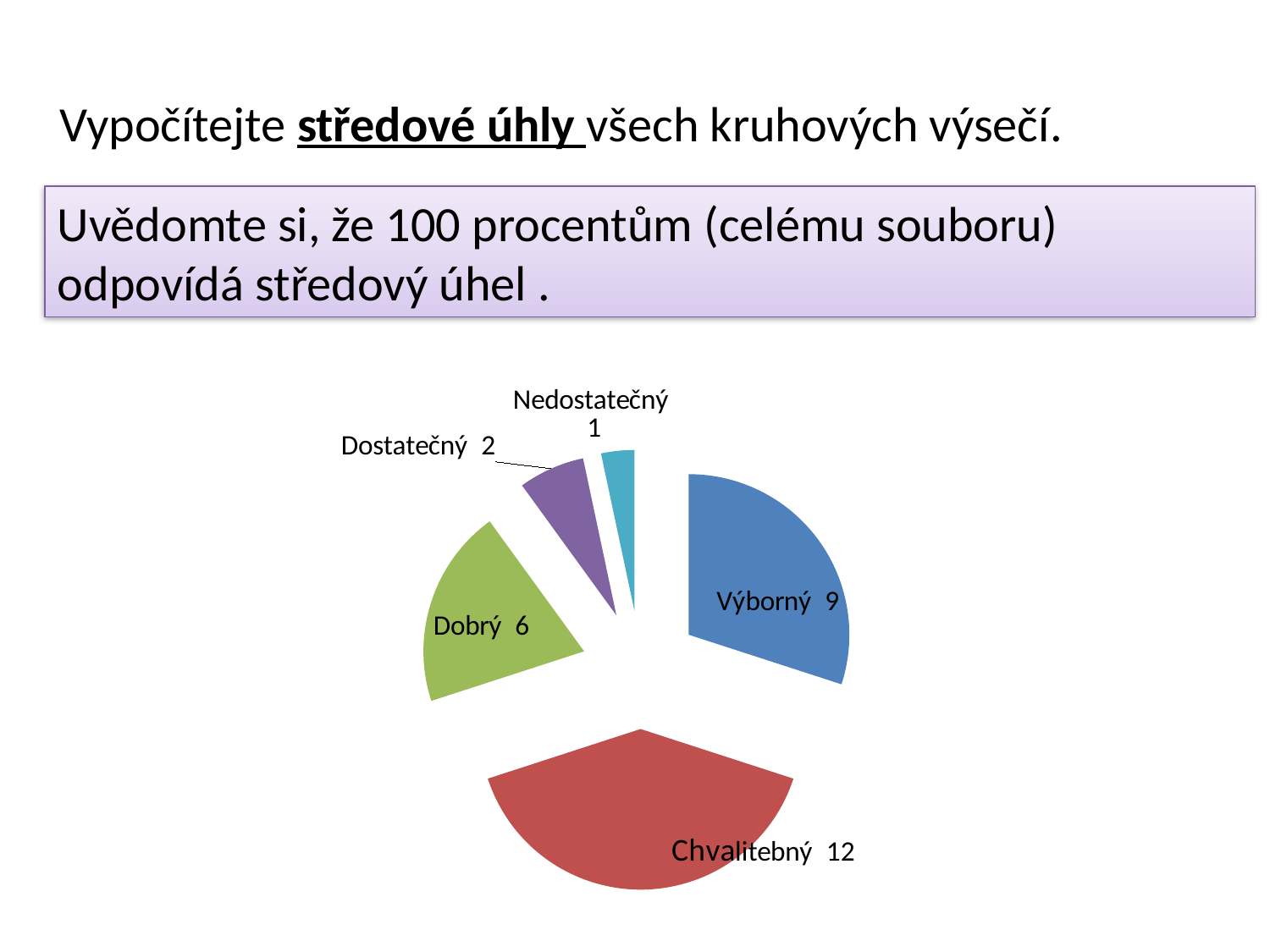
Which category has the largest slice? Chvalitebný What is the value for Dobrý? 6 What kind of chart is shown on the slide? pie chart Which category has the smallest slice? Nedostatečný What is the value for Nedostatečný? 1 What is the value for Výborný? 9 Which is larger, the value for Výborný or the value for Dostatečný? Výborný What share of the whole pie does Chvalitebný represent? 40% What colour is the Dobrý slice? green How many slices does the pie chart have? 5 What is the value for Chvalitebný? 12 What is the difference between the values for Chvalitebný and Dobrý? 6